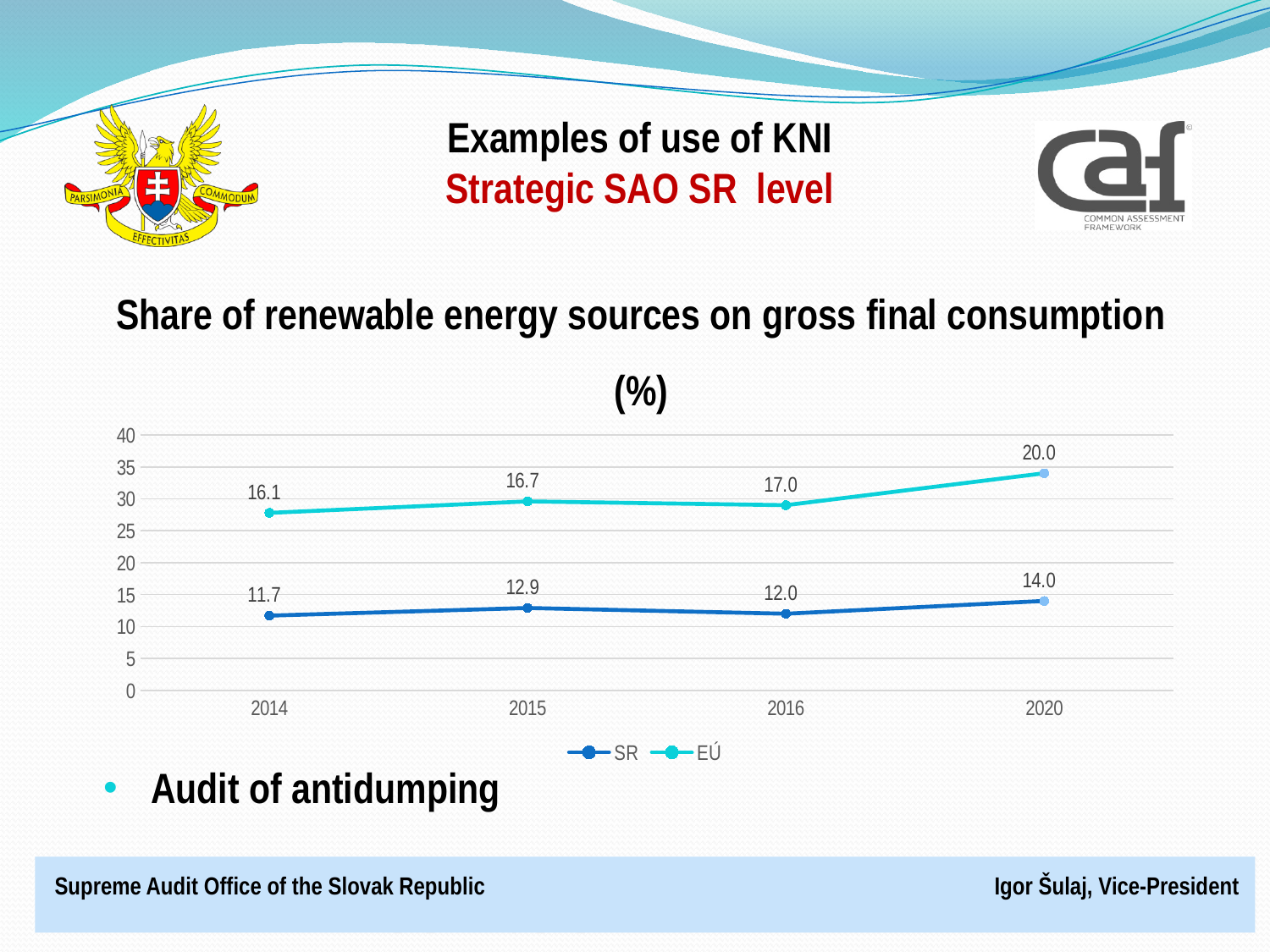
What is the difference between the EÚ and SR values in 2020? 6.0 In which year is the EÚ series lowest? 2014 In which year is the SR series highest? 2020 How many years are shown on the x axis? 4 What is the SR value for 2014? 11.7 How many series does the legend list? 2 What is the EÚ value for 2015? 16.7 What is the SR value for 2016? 12.0 Does the EÚ series rise or fall from 2014 to 2020? rise Which is larger in 2015, the SR value or the EÚ value? EÚ What kind of chart is shown? line chart What is the EÚ value for 2020? 20.0